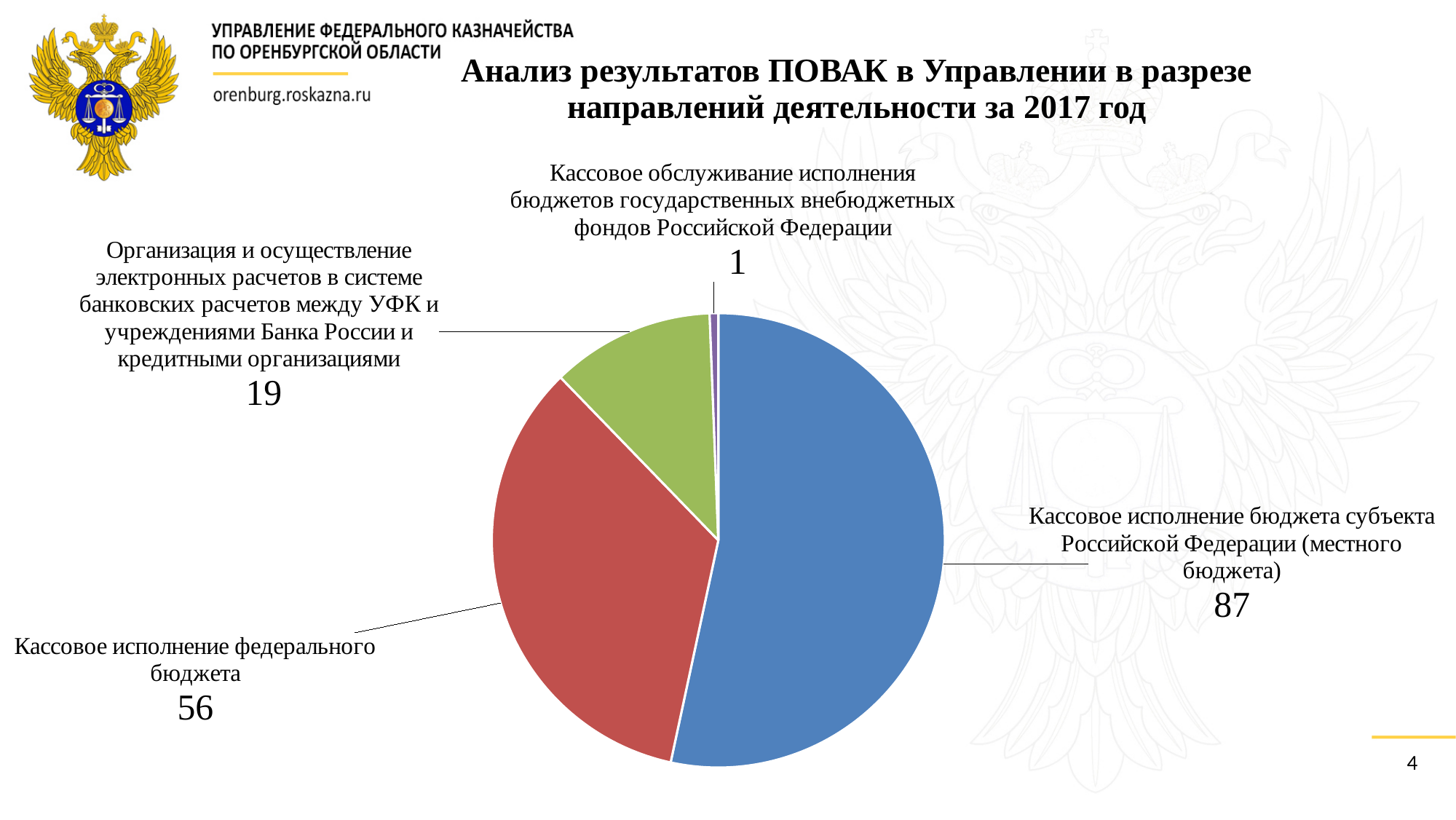
Which category has the largest slice of the pie? Кассовое исполнение бюджета субъекта Российской Федерации (местного бюджета) What is the total of all the values shown in the pie chart? 163 Which category has the smallest slice of the pie? Кассовое обслуживание исполнения бюджетов государственных внебюджетных фондов Российской Федерации What is the difference between the values for «Кассовое исполнение бюджета субъекта Российской Федерации (местного бюджета)» and «Кассовое исполнение федерального бюджета»? 31 What is the value for «Организация и осуществление электронных расчетов в системе банковских расчетов между УФК и учреждениями Банка России и кредитными организациями»? 19 What type of chart is shown on the slide? pie chart What is the value for «Кассовое исполнение федерального бюджета»? 56 What is the value for «Кассовое исполнение бюджета субъекта Российской Федерации (местного бюджета)»? 87 Which is larger: the value for «Кассовое исполнение федерального бюджета» or the value for «Организация и осуществление электронных расчетов...»? Кассовое исполнение федерального бюджета What colour is the slice for «Кассовое исполнение федерального бюджета»? red How many categories (slices) does the pie chart have? 4 What is the value for «Кассовое обслуживание исполнения бюджетов государственных внебюджетных фондов Российской Федерации»? 1